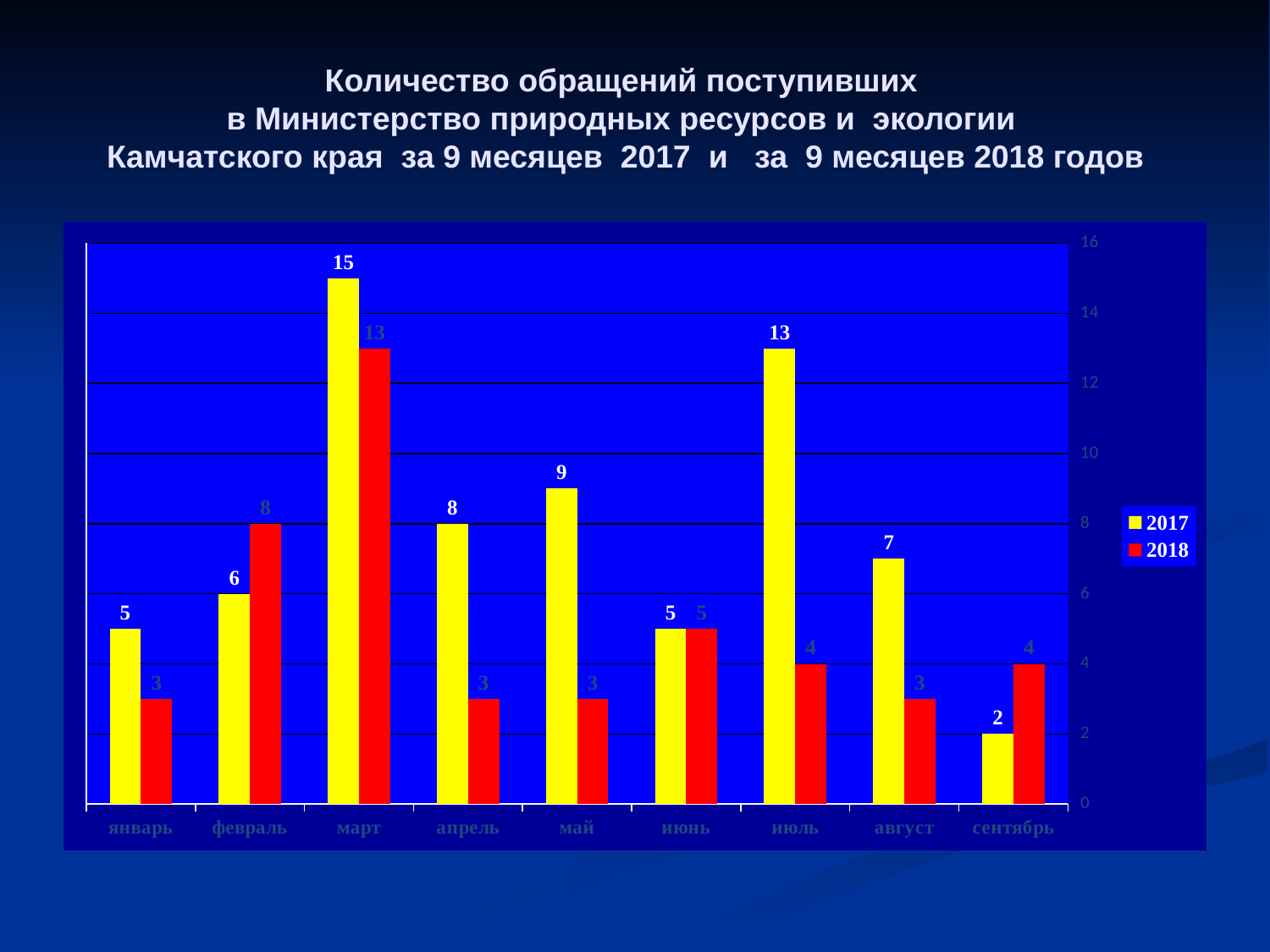
Which month has the highest value for 2017? март What type of chart is shown on the slide? bar chart Which month has the highest value for 2018? март What is the difference between the 2017 and 2018 values in июль (July)? 9 Which is larger in февраль (February): the 2017 value or the 2018 value? 2018 What is the value for 2017 in март (March)? 15 What is the value for 2017 in сентябрь (September)? 2 How many series does the legend list? 2 Which month has the lowest value for 2017? сентябрь How many months are shown on the x axis? 9 What is the value for 2018 in февраль (February)? 8 Which series is shown in red in the legend? 2018